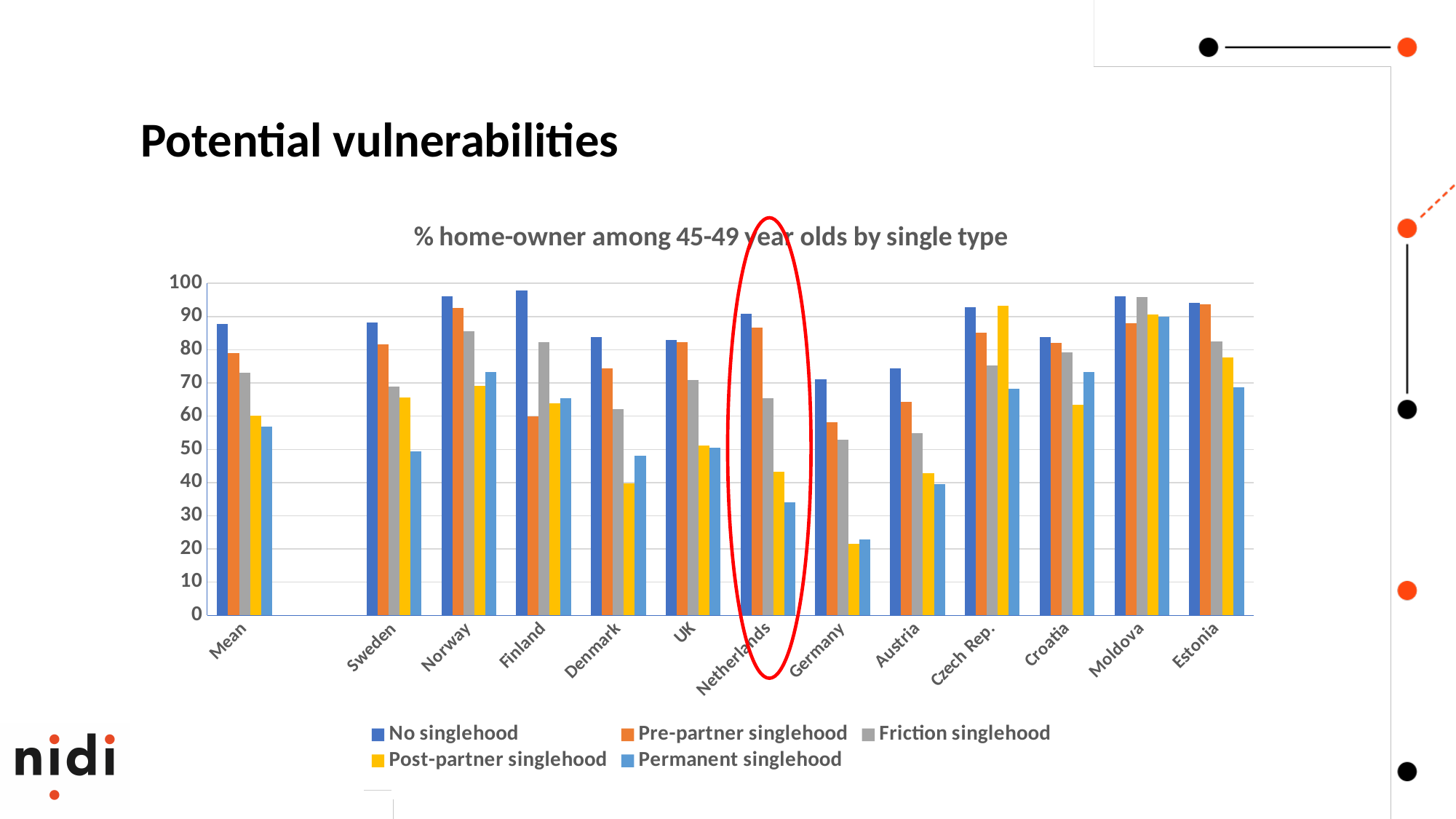
What is the title of the chart? % home-owner among 45-49 year olds by single type Is the value for No singlehood in Finland greater or less than 90? greater How many categories are shown along the x axis? 13 What kind of chart is shown on the slide? bar chart Which country has the lowest value for Permanent singlehood? Germany Which country is circled in red on the chart? Netherlands Is the value for Post-partner singlehood in Denmark greater or less than 50? less Is the value for Post-partner singlehood in Germany greater or less than 30? less In the Netherlands, which is larger: No singlehood or Permanent singlehood? No singlehood How many series does the legend list? 5 In Finland, which is larger: Pre-partner singlehood or Friction singlehood? Friction singlehood